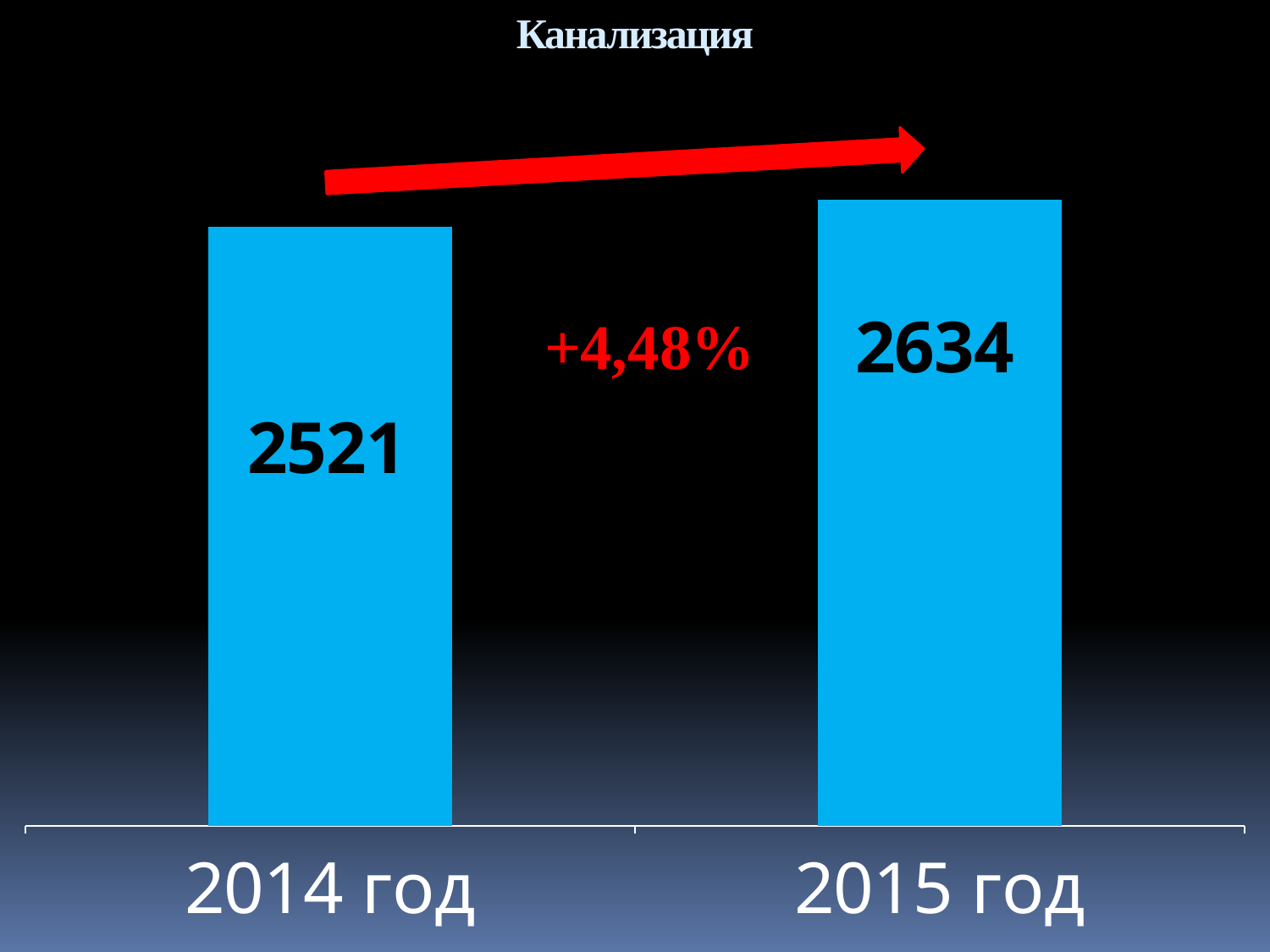
How many categories are shown on the chart? 2 Is the value for 2015 год larger or smaller than the value for 2014 год? larger What is the difference between the values for 2015 год and 2014 год? 113 Which year has the higher value? 2015 год Do the values rise or fall from 2014 год to 2015 год? rise What percentage change is printed in red between the two bars? +4,48% What kind of chart is shown on the slide? bar chart Which year has the lower value? 2014 год What is the value for 2014 год? 2521 What is the title of the chart? Канализация What is the value for 2015 год? 2634